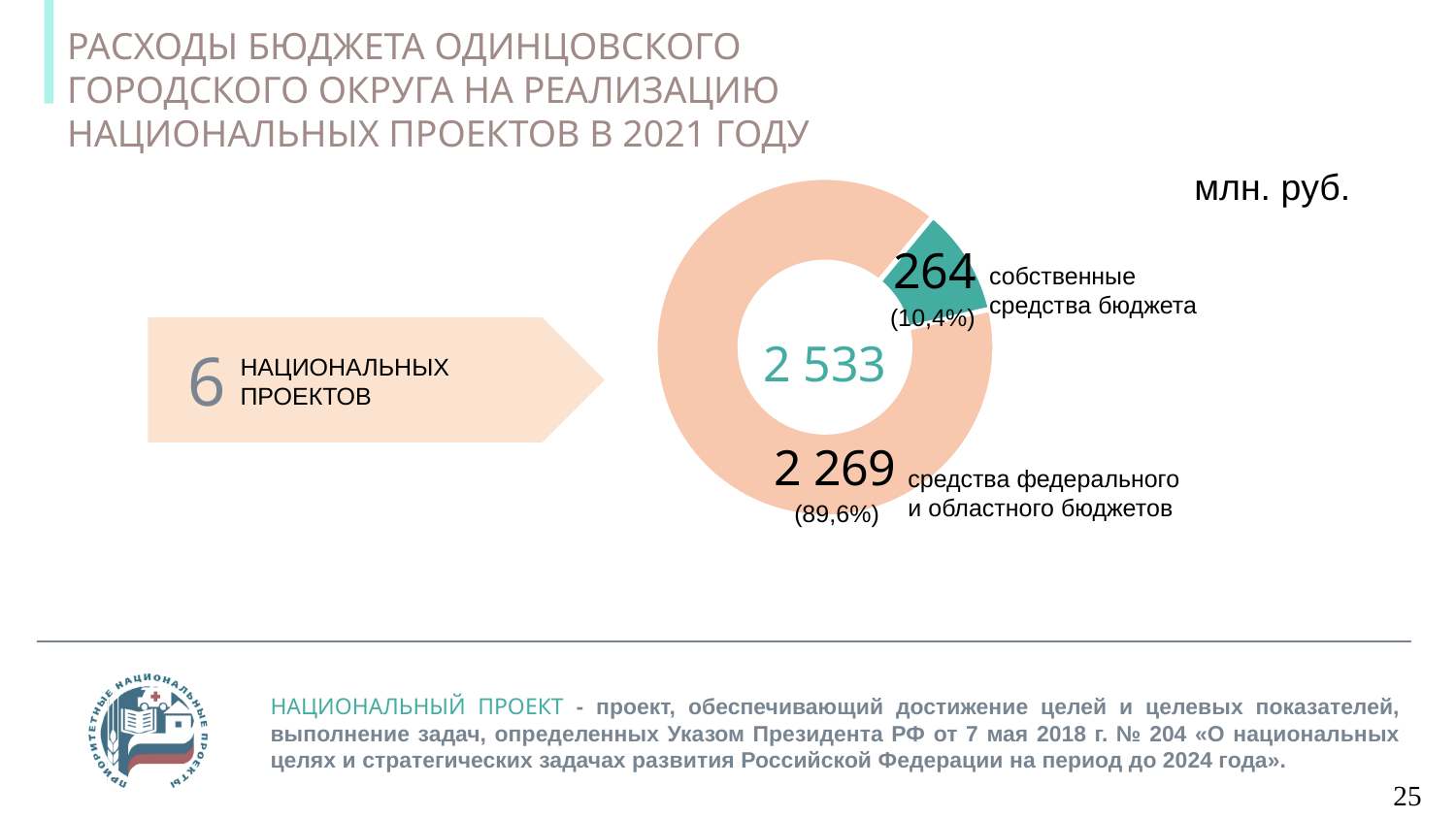
What share of the donut chart is средства федерального и областного бюджетов? 89,6% Which slice of the donut chart is the smallest? собственные средства бюджета What kind of chart is shown on the slide? Donut (pie) chart What share of the donut chart is собственные средства бюджета? 10,4% Which is larger: собственные средства бюджета or средства федерального и областного бюджетов? средства федерального и областного бюджетов What is the value for средства федерального и областного бюджетов? 2 269 What is the difference between средства федерального и областного бюджетов and собственные средства бюджета? 2 005 What total value is shown in the centre of the donut chart? 2 533 How many slices does the donut chart have? 2 What is the value for собственные средства бюджета? 264 In what units are the values of the donut chart given? млн. руб. Which slice of the donut chart is the largest? средства федерального и областного бюджетов